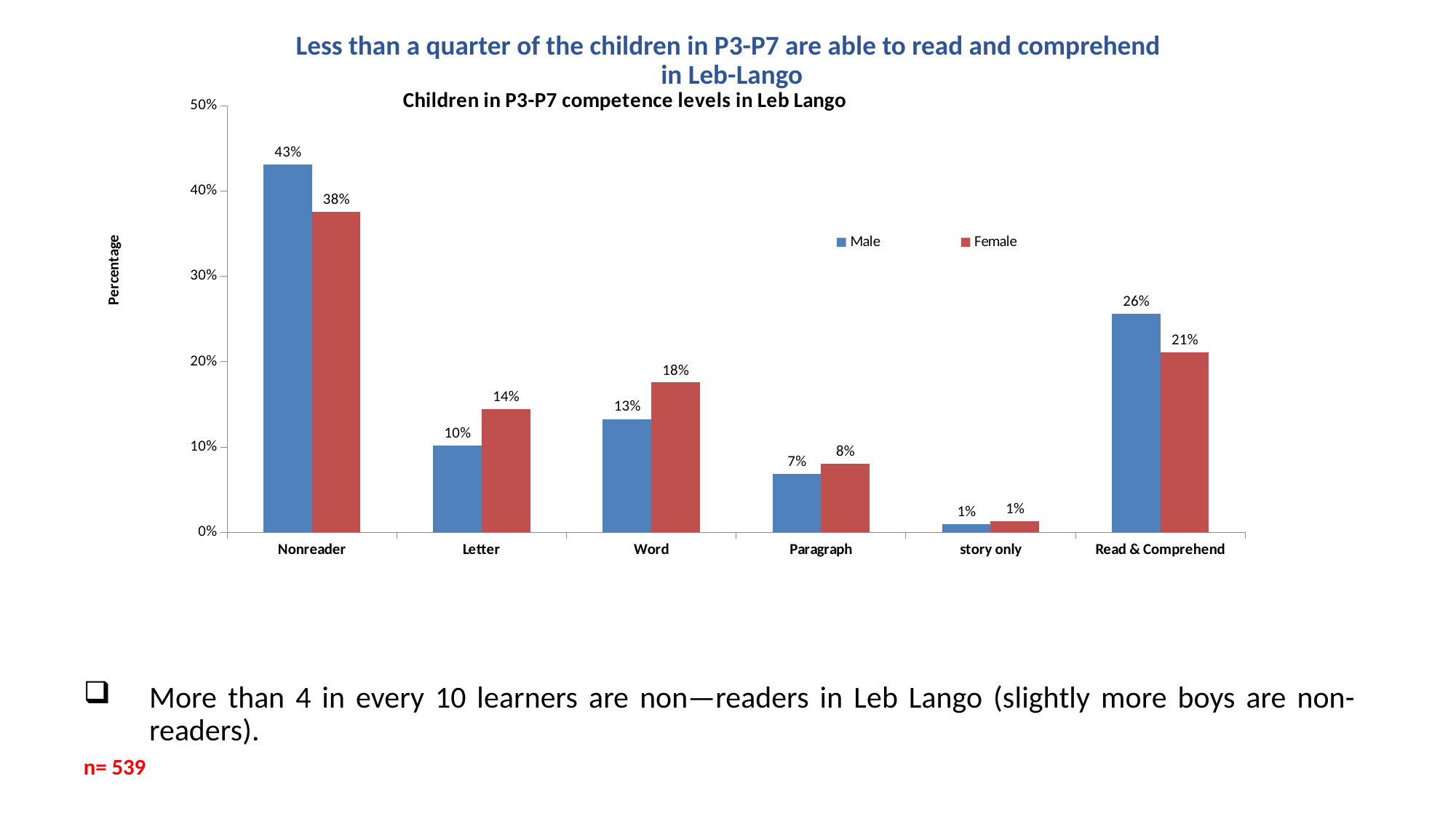
Which is larger for Word, the Male value or the Female value? Female How many categories are shown on the x axis? 6 What is the difference between the Female and Male values for Letter? 4% What is the label on the vertical axis? Percentage Which category has the highest Male value? Nonreader Which category has the lowest Female value? story only What is the difference between the Male and Female values for Nonreader? 5% What is the Male value for Nonreader? 43% What is the Female value for Word? 18% What is the Female value for Read & Comprehend? 21% How many series does the legend list? 2 What kind of chart is shown on the slide? Bar chart